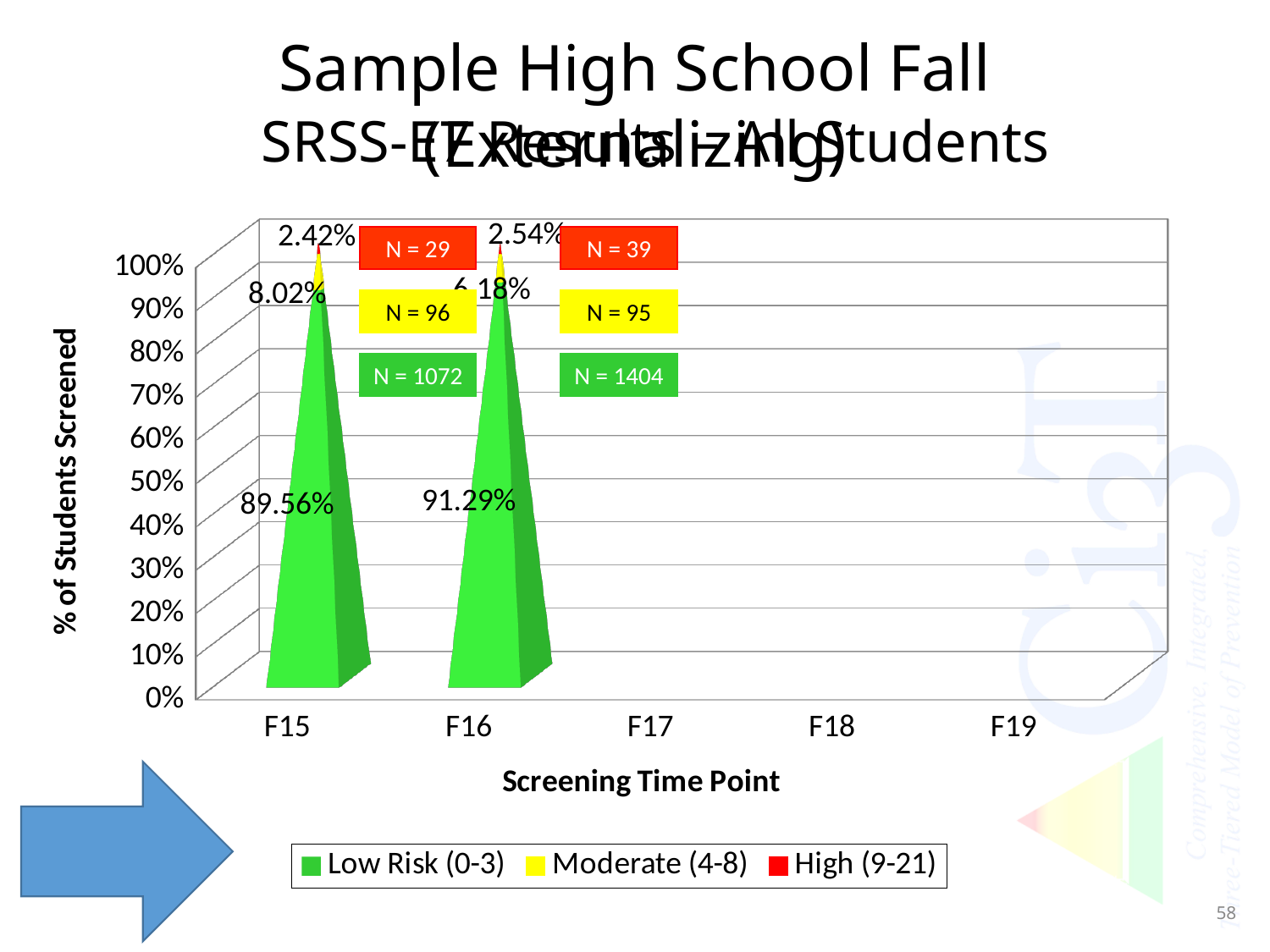
What is the Low Risk (0-3) value for F15? 89.56% Which screening time point has the higher Low Risk (0-3) percentage, F15 or F16? F16 What is the High (9-21) value for F16? 2.54% What is the Low Risk (0-3) value for F16? 91.29% What is the Moderate (4-8) value for F15? 8.02% Which risk category has the largest share at F15? Low Risk (0-3) What is the difference between the Low Risk (0-3) values for F16 and F15? 1.73 percentage points What is the difference between the High (9-21) values for F16 and F15? 0.12 percentage points What is the High (9-21) value for F15? 2.42% Does the Low Risk (0-3) percentage rise or fall from F15 to F16? rise How many screening time points are labelled on the x axis? 5 How many series does the legend list? 3